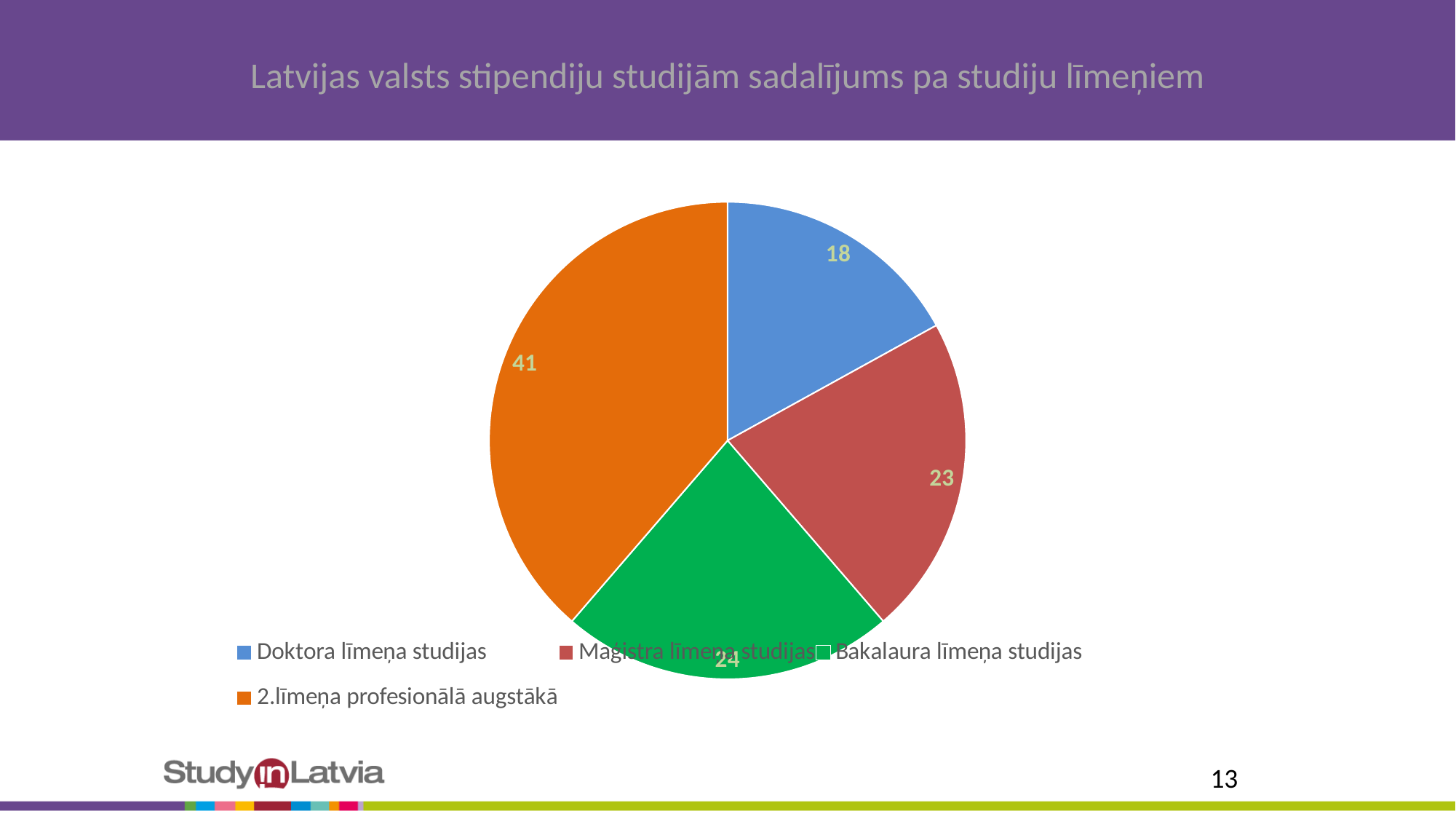
Which study level has the largest slice of the pie? 2.līmeņa profesionālā augstākā What value is shown for the 2.līmeņa profesionālā augstākā slice? 41 What kind of chart is shown on the slide? Pie chart How many slices does the pie chart have? 4 What is the difference between the values for Bakalaura līmeņa studijas and Maģistra līmeņa studijas? 1 What is the title of the chart? Latvijas valsts stipendiju studijām sadalījums pa studiju līmeņiem What value is shown for the Bakalaura līmeņa studijas slice? 24 Which study level has the smallest slice of the pie? Doktora līmeņa studijas What value is shown for the Maģistra līmeņa studijas slice? 23 Which is larger, the value for Maģistra līmeņa studijas or for Bakalaura līmeņa studijas? Bakalaura līmeņa studijas What is the difference between the values for 2.līmeņa profesionālā augstākā and Doktora līmeņa studijas? 23 What value is shown for the Doktora līmeņa studijas slice? 18